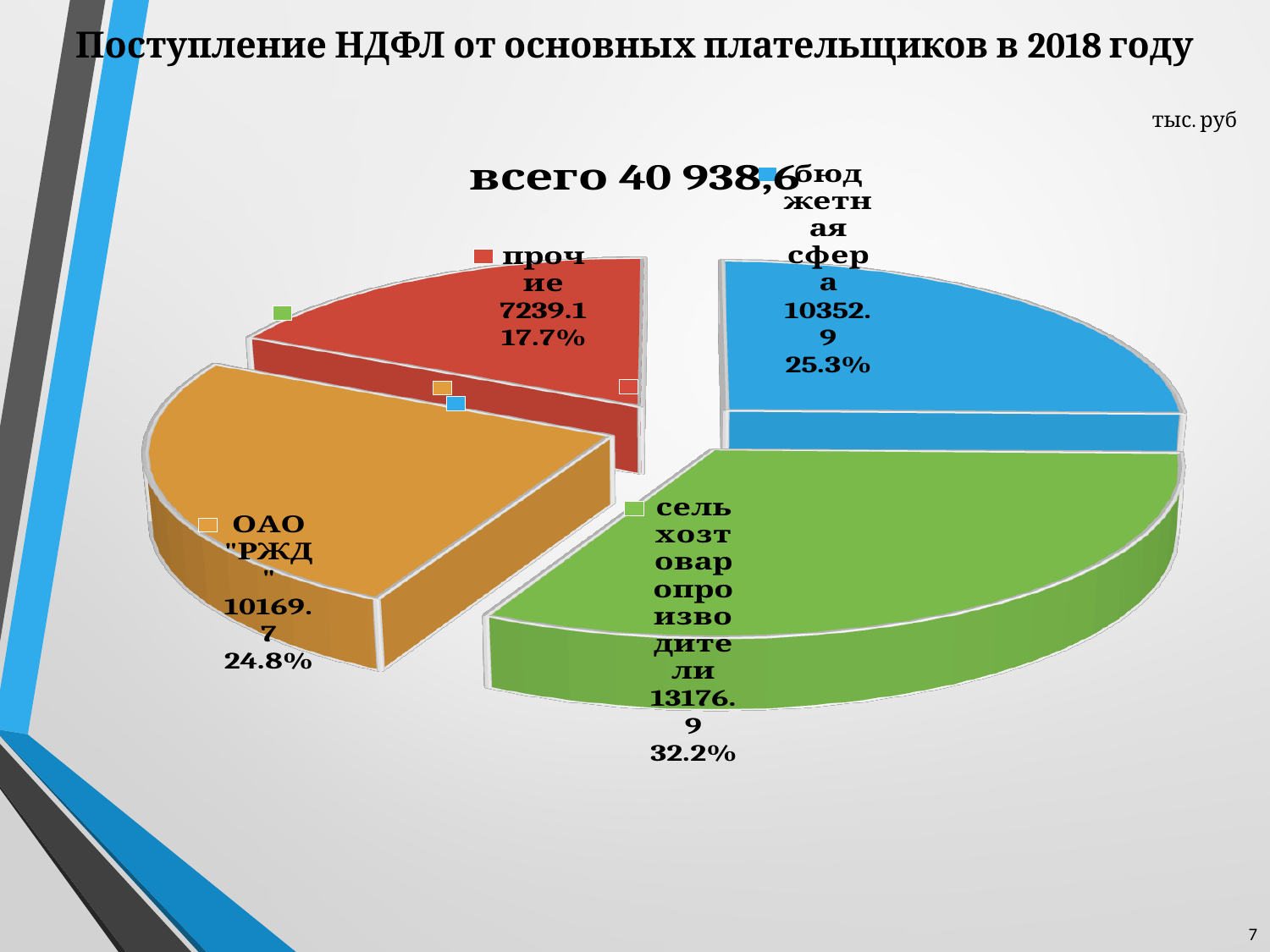
What share of the pie does сельхозтоваропроизводители represent? 32.2% What is the value for ОАО "РЖД"? 10169.7 What share of the pie does прочие represent? 17.7% What kind of chart is shown on the slide? pie chart What is the value for бюджетная сфера? 10352.9 What total is stated in the chart title? 40 938,6 What is the value for сельхозтоваропроизводители? 13176.9 What is the value for прочие? 7239.1 What is the difference between the values for сельхозтоваропроизводители and прочие? 5937.8 Which category has the smallest value? прочие How many slices does the pie chart have? 4 Which category has the largest value? сельхозтоваропроизводители